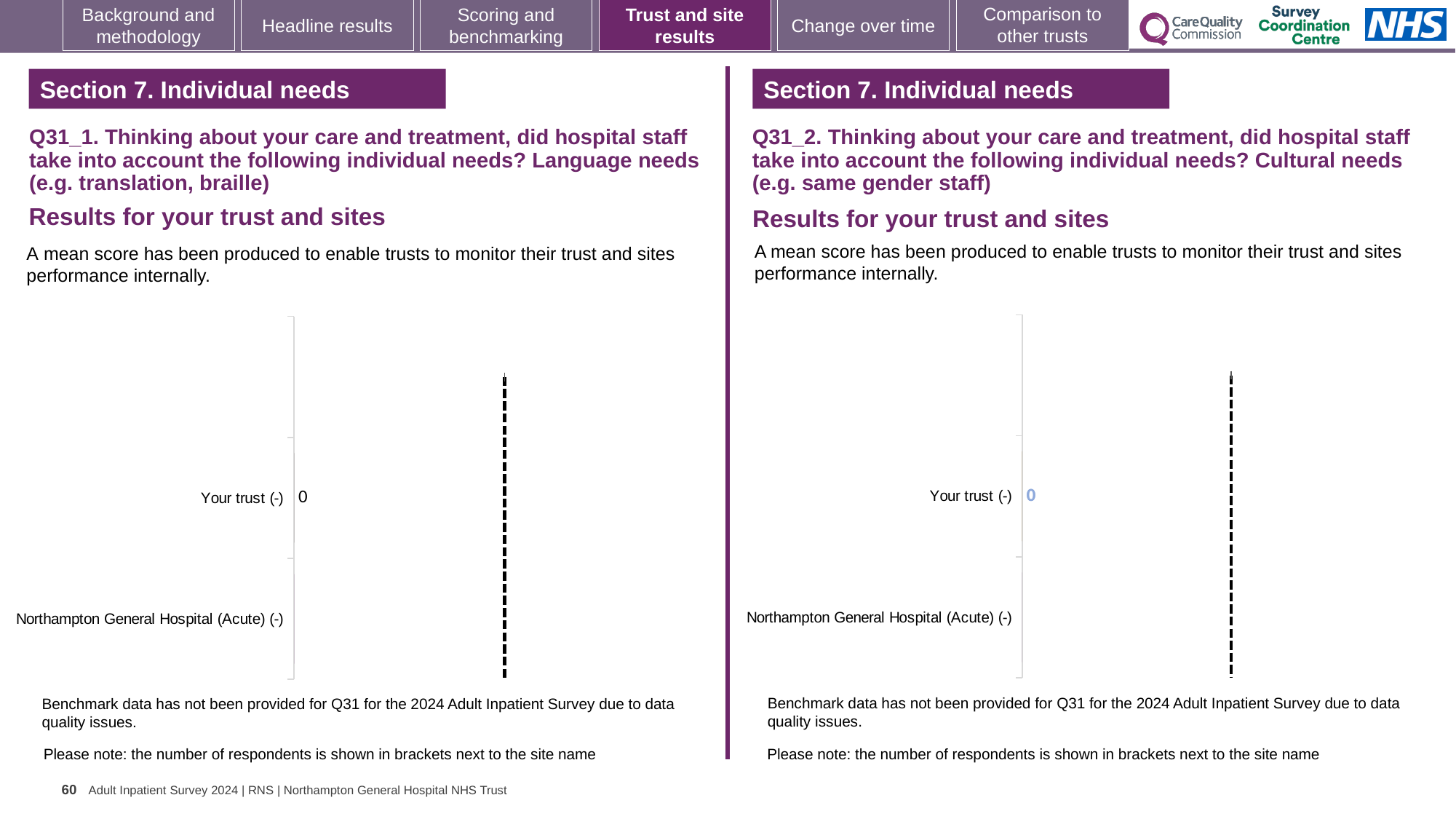
On the left chart (Q31_1, Language needs), which site is listed below Your trust? Northampton General Hospital (Acute) What kind of chart is used on the right side of the slide (Q31_2, Cultural needs)? bar chart How many categories are listed on the right chart (Q31_2, Cultural needs)? 2 On the right chart (Q31_2, Cultural needs), what number of respondents is shown in brackets next to Your trust? - On the left chart (Q31_1, Language needs), what value is shown for Your trust? 0 What kind of chart is used on the left side of the slide (Q31_1, Language needs)? bar chart On the right chart (Q31_2, Cultural needs), what value is shown for Your trust? 0 How many categories are listed on the left chart (Q31_1, Language needs)? 2